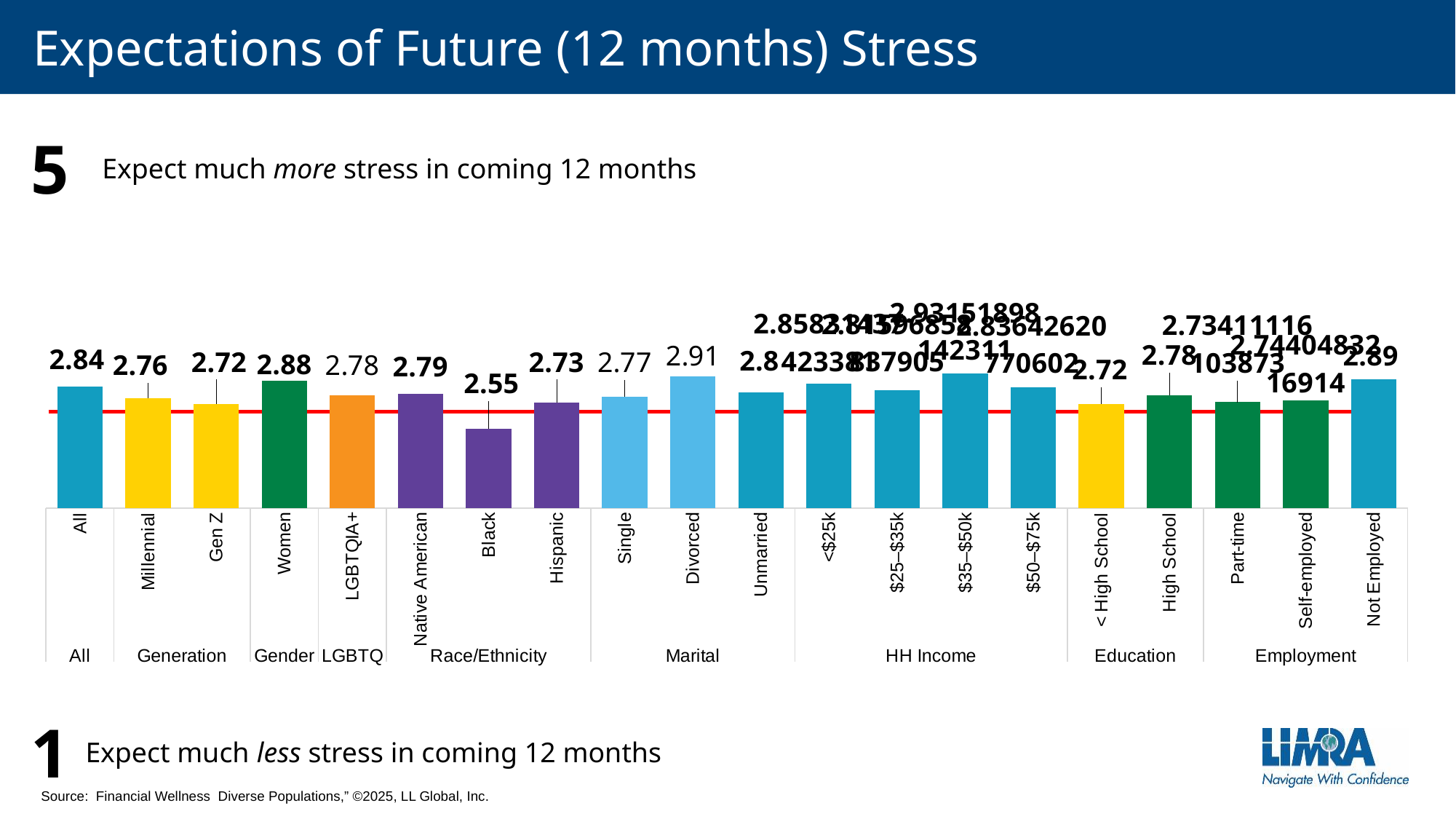
What is the value for All? 2.84 What is the value for Women? 2.88 What is the difference between the values for Women and Gen Z? 0.16 Which is larger, the value for Millennial or the value for Gen Z? Millennial Which group heading covers the Single, Divorced and Unmarried bars? Marital Which category has the lowest value? Black What is the difference between the values for Divorced and Single? 0.14 What kind of chart is shown on the slide? bar chart What is the value for Not Employed? 2.89 What is the value for Black? 2.55 How many bars are plotted in the chart? 20 What is the value for Divorced? 2.91